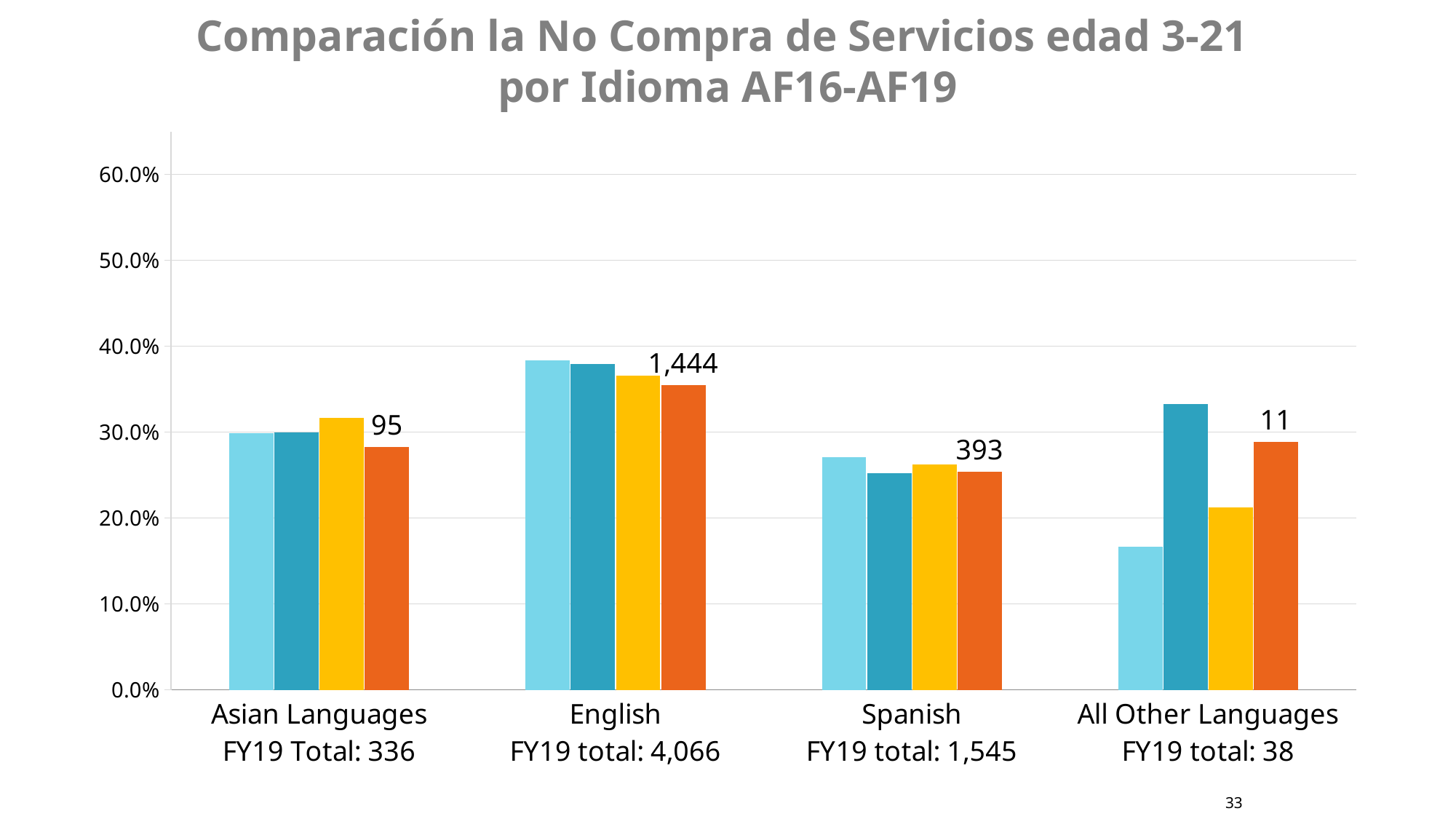
What FY19 total is given in the axis label for English? 4,066 Which language category has the highest bars overall? English What kind of chart is shown on the slide? bar chart What data label is printed above the orange bar for Spanish? 393 Which is larger, the light blue bar for English or the light blue bar for Spanish? English What is the title of the chart? Comparación la No Compra de Servicios edad 3-21 por Idioma AF16-AF19 Is the value of the light blue bar for English greater or less than 30.0%? greater Is the value of the light blue bar for All Other Languages greater or less than 20.0%? less What data label is printed above the orange bar for All Other Languages? 11 How many bars are plotted for each language category? 4 What data label is printed above the orange bar for English? 1,444 How many language categories are shown on the x axis? 4